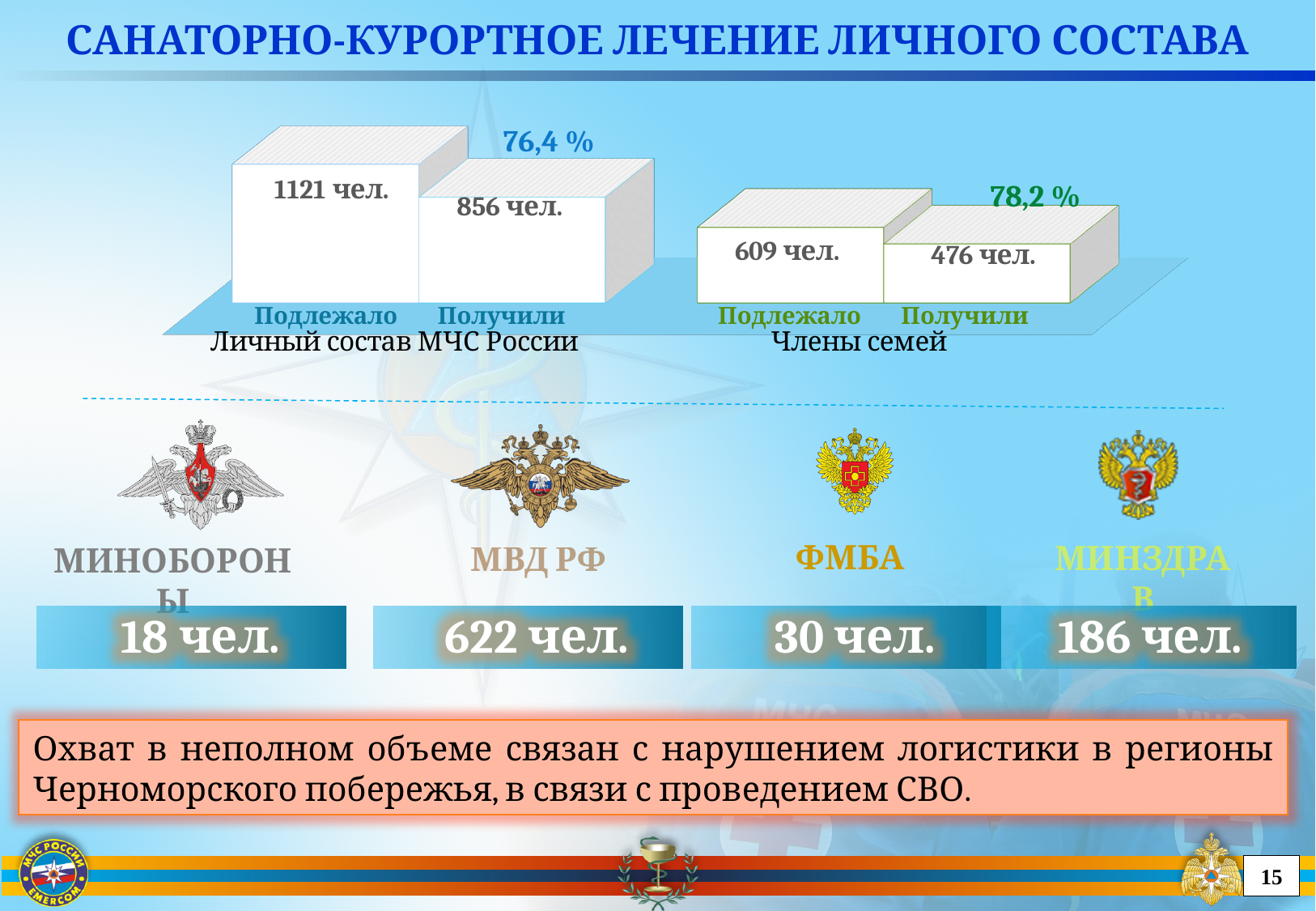
In the chart for Личный состав МЧС России, what is the value for Подлежало? 1121 чел. How many bars does the chart for Члены семей contain? 2 In the chart for Члены семей, what is the difference between Подлежало and Получили? 133 чел. What type of chart is used for Личный состав МЧС России? Bar chart In the chart for Члены семей, what is the value for Подлежало? 609 чел. In the chart for Личный состав МЧС России, what is the difference between Подлежало and Получили? 265 чел. In the chart for Члены семей, what percentage is shown above the Получили bar? 78,2 % In the chart for Личный состав МЧС России, which bar is taller, Подлежало or Получили? Подлежало In the chart for Личный состав МЧС России, what percentage is shown above the Получили bar? 76,4 % In the chart for Члены семей, which category has the lowest value? Получили In the chart for Личный состав МЧС России, what is the value for Получили? 856 чел. In the chart for Члены семей, what is the value for Получили? 476 чел.